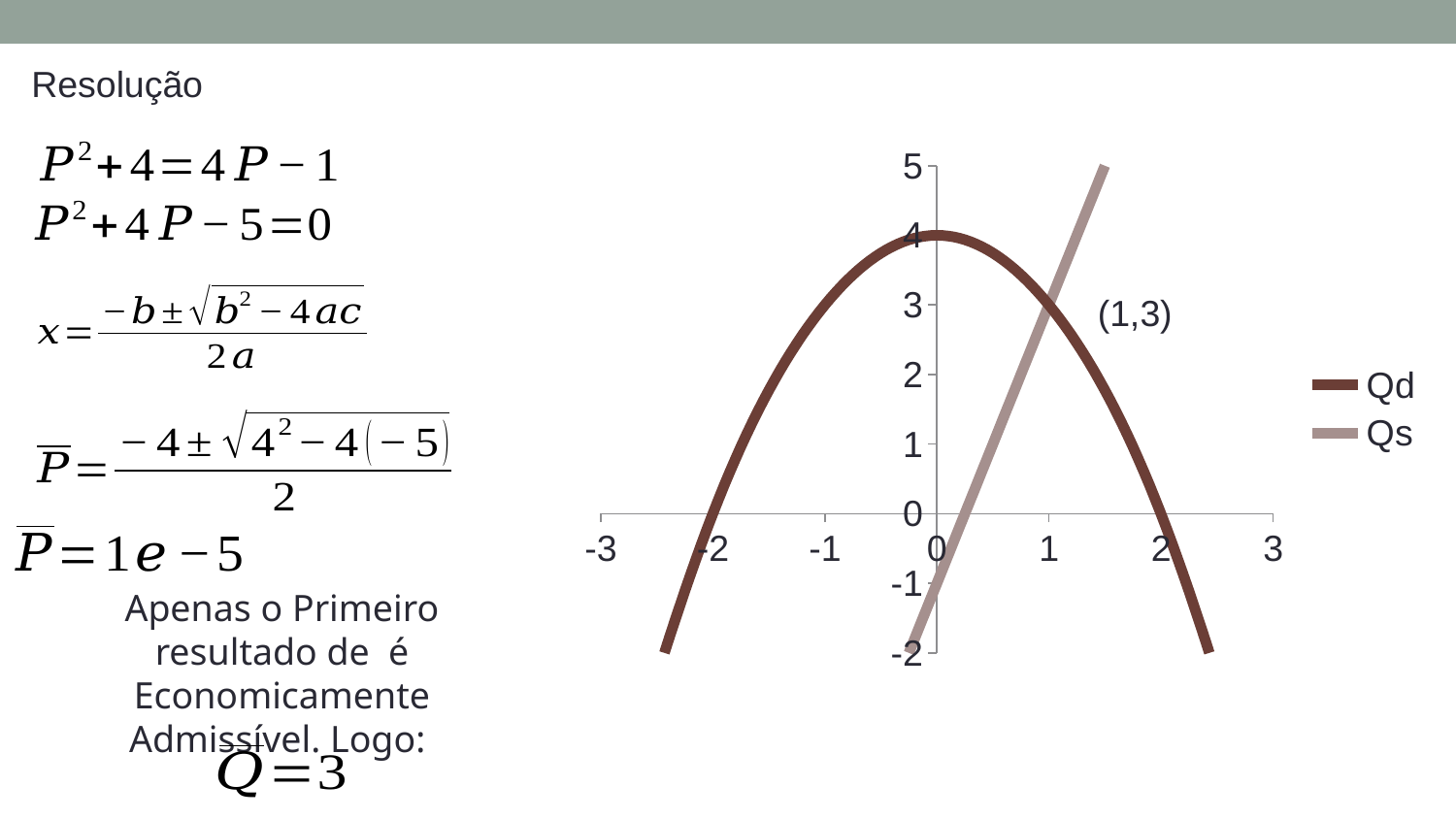
What are the names of the two series in the chart legend? Qd and Qs Does the Qs line rise or fall as x increases? rise What is the value of Qs at x = 1, according to the labeled intersection point? 3 What is the highest value shown on the vertical axis of the chart? 5 What kind of chart is shown on the slide? line chart At what point do the Qd and Qs curves intersect, according to the label on the chart? (1,3) Does the Qd curve rise or fall as x increases from 0 to 2? fall Is the value of Qd at x = 0 greater or less than 3? greater Is the value of Qs at x = 0 greater or less than 0? less How many series does the chart legend list? 2